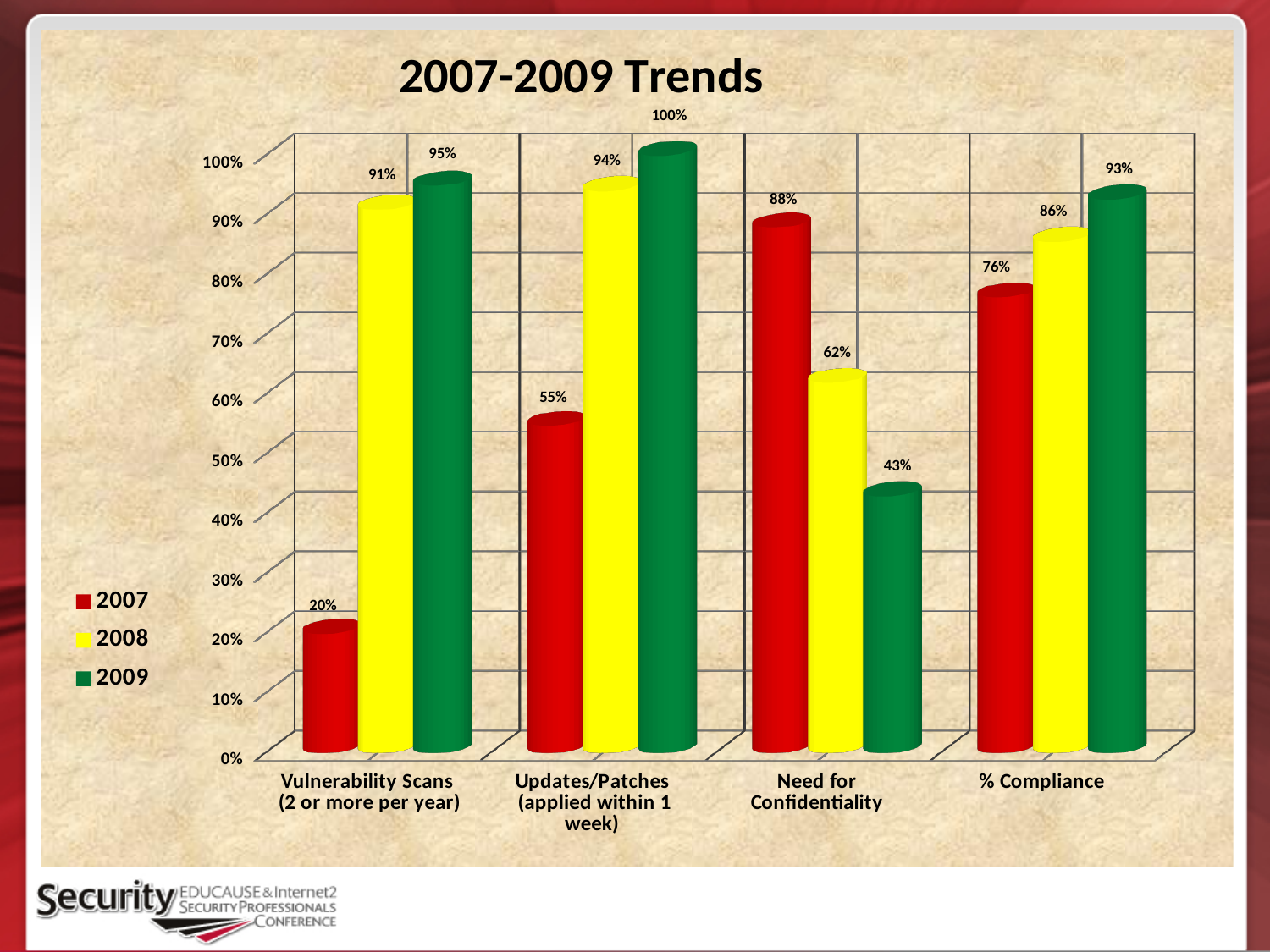
What is the difference between the 2009 and 2007 values for Vulnerability Scans (2 or more per year)? 75% What is the 2008 value for Need for Confidentiality? 62% How many series does the legend list? 3 What kind of chart is shown on the slide? Bar chart Which is larger for Need for Confidentiality, the 2007 value or the 2009 value? 2007 What is the 2007 value for Vulnerability Scans (2 or more per year)? 20% Which category has the lowest 2009 value? Need for Confidentiality Which category has the highest 2007 value? Need for Confidentiality What is the title of the chart? 2007-2009 Trends How many categories are shown on the x axis? 4 What is the 2009 value for % Compliance? 93% What is the 2009 value for Updates/Patches (applied within 1 week)? 100%